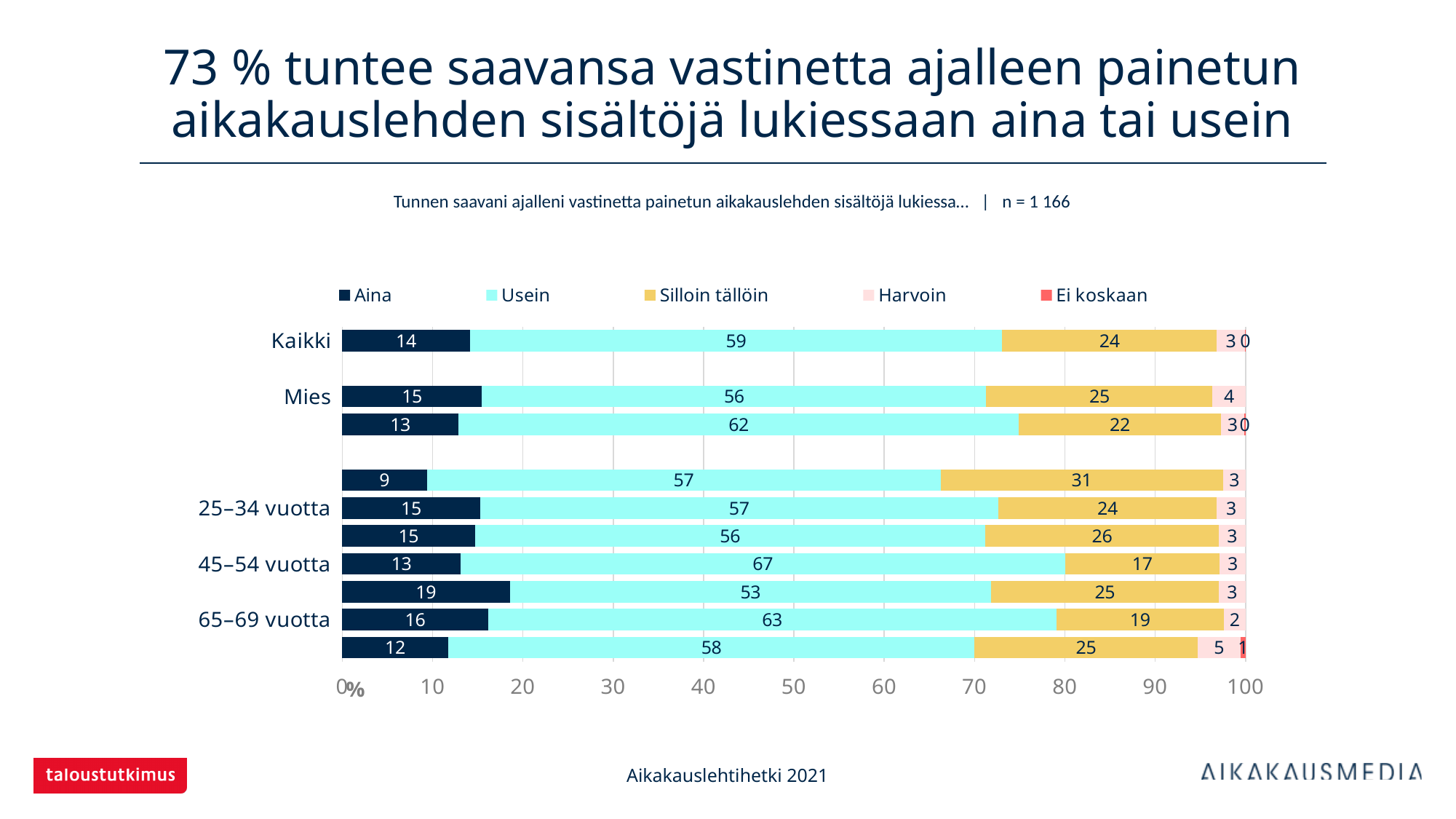
What is the value of the Harvoin segment for Mies? 4 What is the difference between the Silloin tällöin value for Mies and the Silloin tällöin value for 45–54 vuotta? 8 What is the first entry in the chart's legend? Aina What kind of chart is shown on the slide? Stacked bar chart Which has a larger Usein value, 45–54 vuotta or 25–34 vuotta? 45–54 vuotta What is the value of the Usein segment for Mies? 56 What is the value of the Aina segment for Kaikki? 14 What is the value of the Silloin tällöin segment for 25–34 vuotta? 24 What is the difference between the Aina value for 65–69 vuotta and the Aina value for Kaikki? 2 How many series does the legend list? 5 What is the value of the Usein segment for 45–54 vuotta? 67 What is the value of the Silloin tällöin segment for 65–69 vuotta? 19